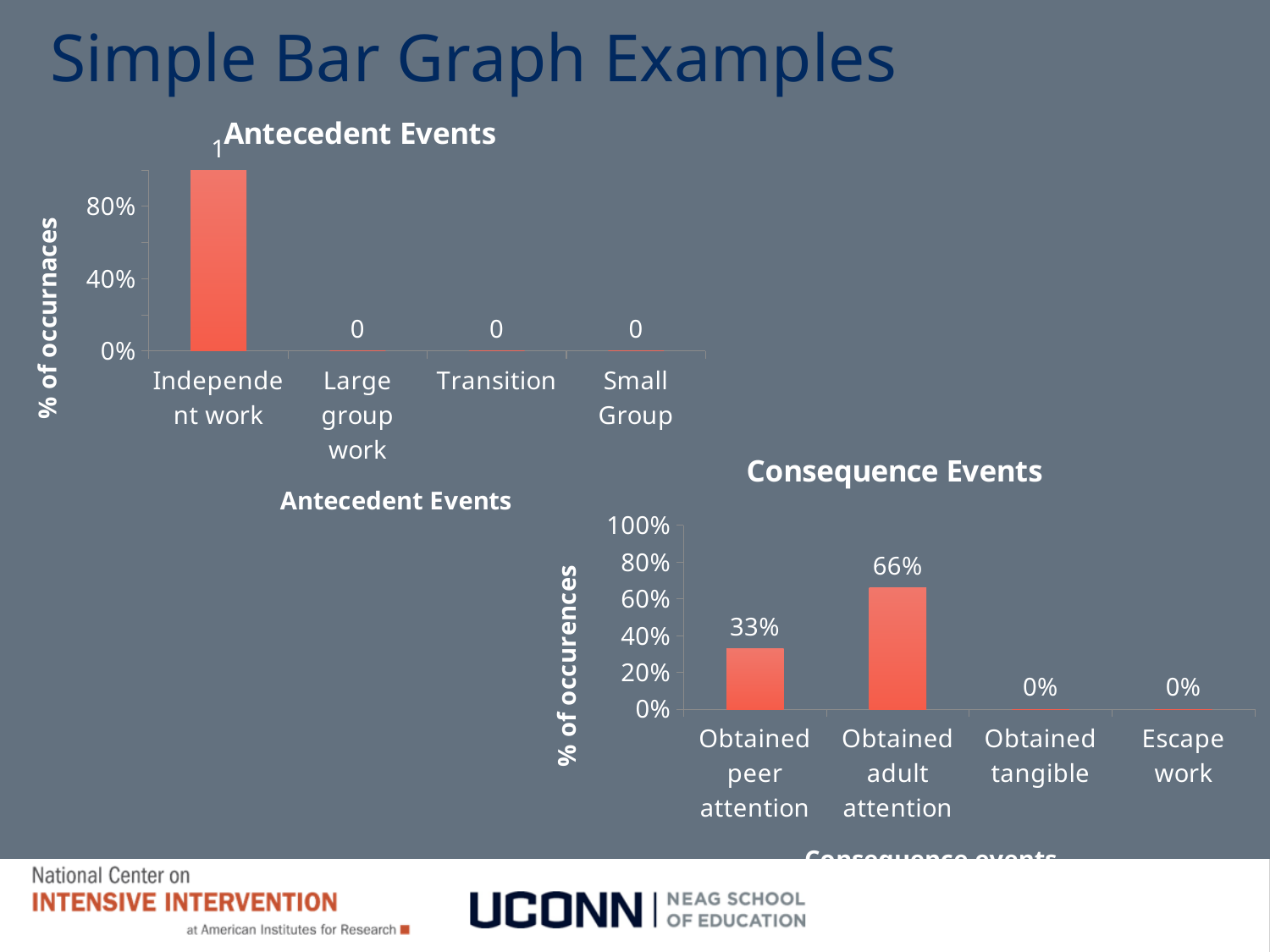
In the Consequence Events chart, what is the difference between Obtained adult attention and Obtained peer attention? 33% In the Antecedent Events chart, how many categories are shown on the x axis? 4 In the Consequence Events chart, which category has the highest value? Obtained adult attention In the Antecedent Events chart, what is the value for Transition? 0 In the Consequence Events chart, what is the value for Obtained peer attention? 33% In the Consequence Events chart, what is the value for Escape work? 0% In the Consequence Events chart, what is the value for Obtained adult attention? 66% In the Consequence Events chart, which is larger: Obtained peer attention or Obtained tangible? Obtained peer attention In the Antecedent Events chart, what is the data label shown for Independent work? 1 In the Antecedent Events chart, which category has the highest value? Independent work In the Antecedent Events chart, is the value for Independent work greater or less than 80%? greater What type of chart is the Consequence Events chart? Bar chart